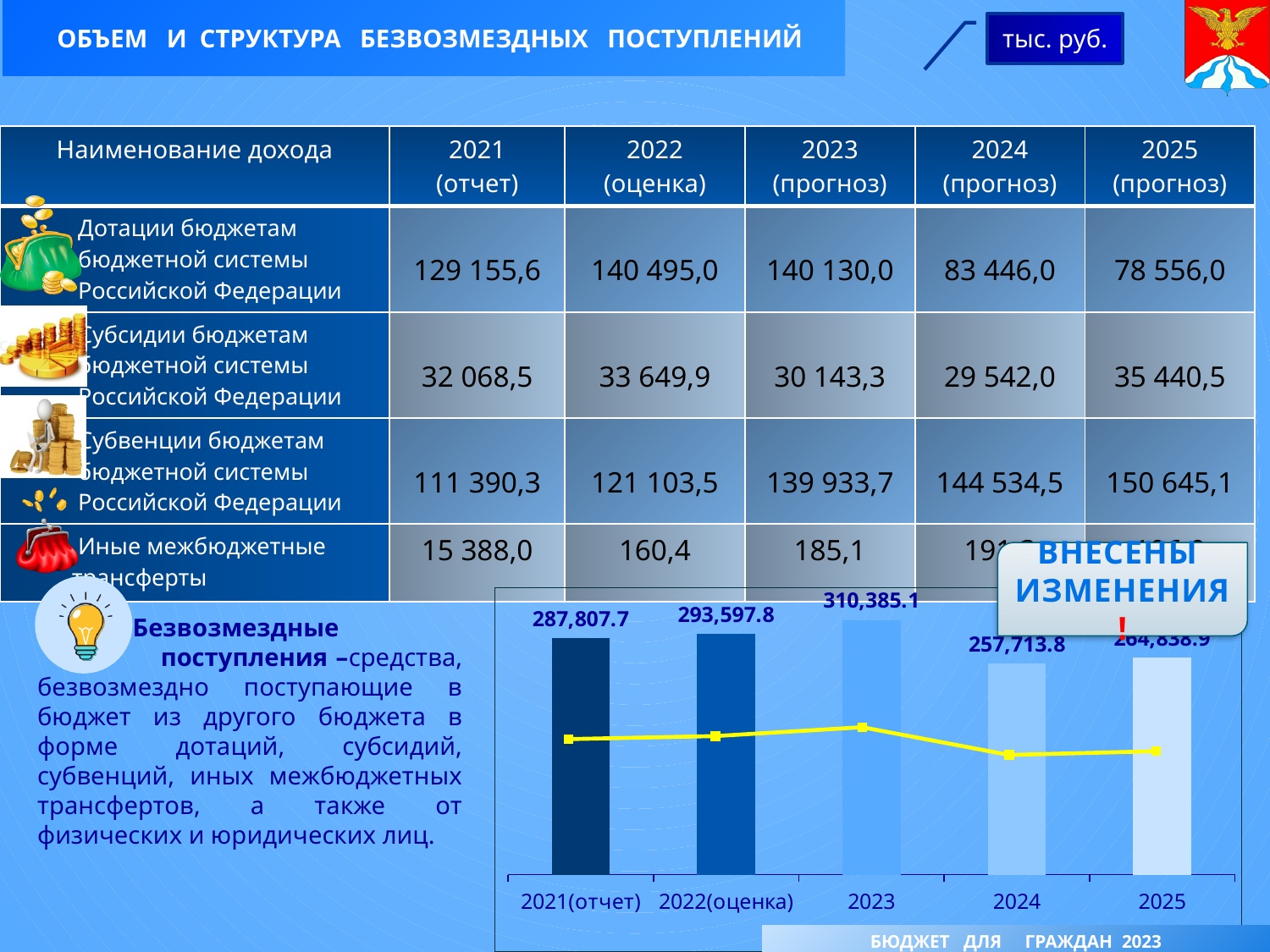
In the bar chart at the bottom right of the slide, do the values rise or fall from 2021(отчет) to 2023? rise In the bar chart at the bottom right of the slide, what is the value for 2023? 310,385.1 What kind of chart is shown at the bottom right of the slide? bar chart In the bar chart at the bottom right of the slide, what is the value for 2021(отчет)? 287,807.7 How many bars (years) are shown in the bar chart at the bottom right of the slide? 5 In the bar chart at the bottom right of the slide, what is the difference between the 2022(оценка) value and the 2021(отчет) value? 5,790.1 In the bar chart at the bottom right of the slide, what is the value for 2024? 257,713.8 In the bar chart at the bottom right of the slide, what is the difference between the 2023 value and the 2021(отчет) value? 22,577.4 In the bar chart at the bottom right of the slide, what is the difference between the 2023 value and the 2024 value? 52,671.3 In the bar chart at the bottom right of the slide, what is the value for 2022(оценка)? 293,597.8 In the bar chart at the bottom right of the slide, which is larger: the value for 2023 or the value for 2024? 2023 In the bar chart at the bottom right of the slide, which year has the highest value? 2023